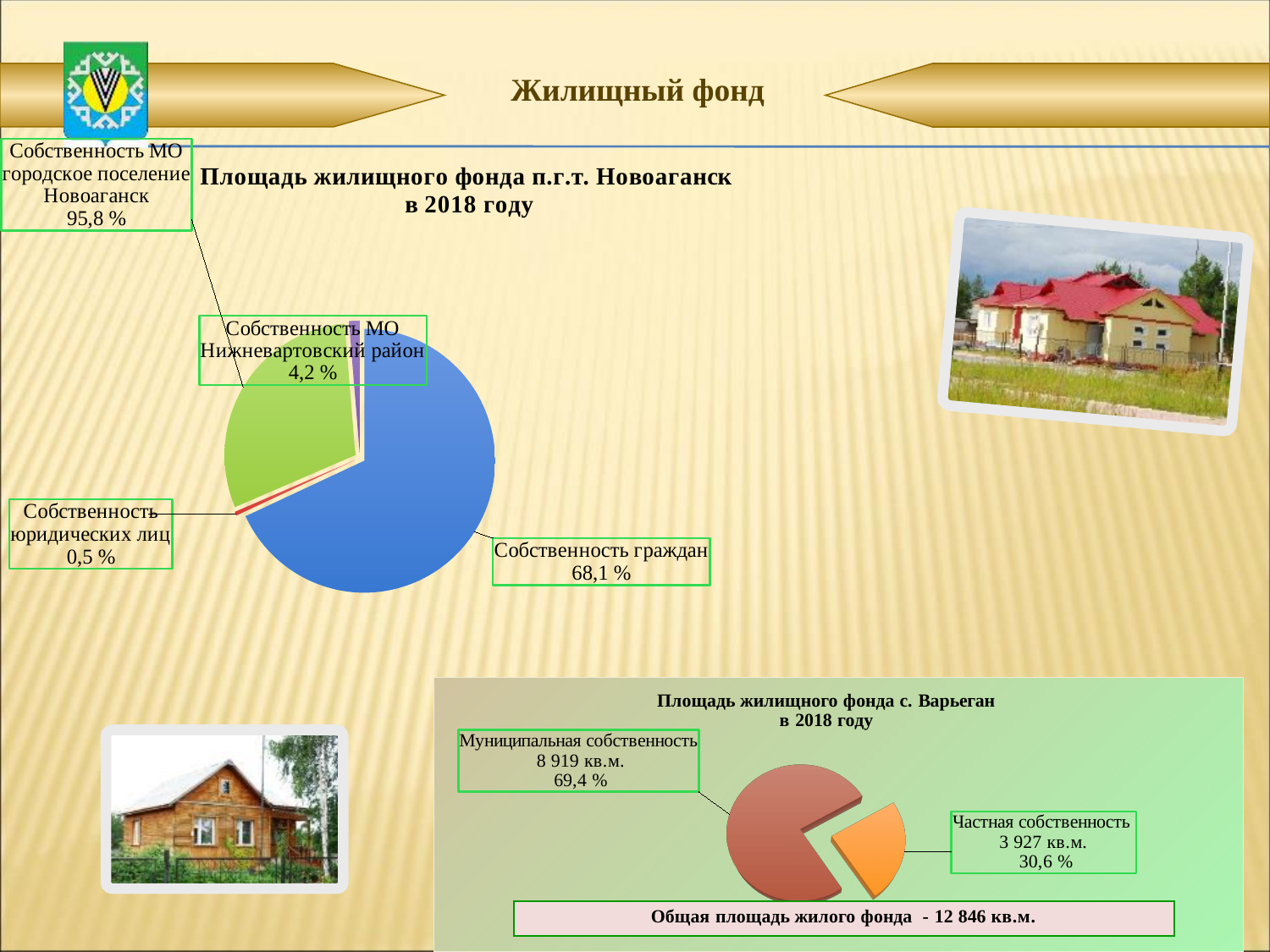
What total area of housing stock is stated below the chart "Площадь жилищного фонда с. Варьеган в 2018 году"? 12 846 кв.м. In the chart "Площадь жилищного фонда п.г.т. Новоаганск в 2018 году", what share is labelled for "Собственность граждан"? 68,1 % In the chart "Площадь жилищного фонда п.г.т. Новоаганск в 2018 году", what share is labelled for "Собственность МО Нижневартовский район"? 4,2 % In the chart "Площадь жилищного фонда п.г.т. Новоаганск в 2018 году", which slice is the largest? Собственность граждан What kind of chart is the chart titled "Площадь жилищного фонда п.г.т. Новоаганск в 2018 году"? pie chart In the chart "Площадь жилищного фонда п.г.т. Новоаганск в 2018 году", what share is labelled for "Собственность юридических лиц"? 0,5 % In the chart "Площадь жилищного фонда с. Варьеган в 2018 году", how many slices does the pie have? 2 In the chart "Площадь жилищного фонда с. Варьеган в 2018 году", what percentage is labelled for "Частная собственность"? 30,6 % In the chart "Площадь жилищного фонда п.г.т. Новоаганск в 2018 году", which slice is the smallest? Собственность юридических лиц In the chart "Площадь жилищного фонда с. Варьеган в 2018 году", what area is labelled for "Муниципальная собственность"? 8 919 кв.м. In the chart "Площадь жилищного фонда с. Варьеган в 2018 году", what is the difference in area between "Муниципальная собственность" and "Частная собственность"? 4 992 кв.м. In the chart "Площадь жилищного фонда с. Варьеган в 2018 году", which is larger: "Муниципальная собственность" or "Частная собственность"? Муниципальная собственность